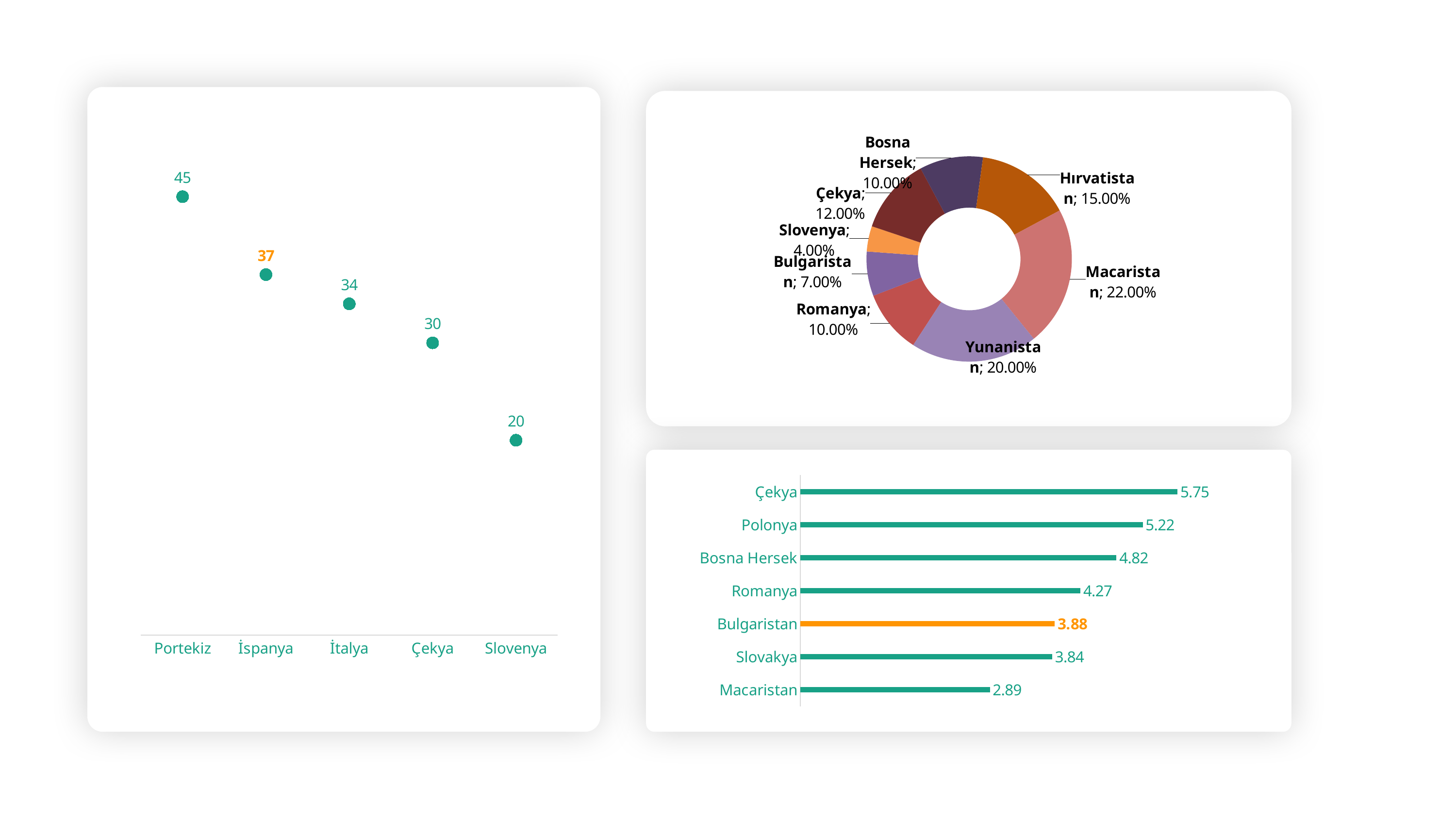
In the left chart, how many data points are plotted? 5 In the left chart, do the values rise or fall from Portekiz to Slovenya? fall In the left chart, what is the value for Portekiz? 45 In the top-right doughnut chart, which category has the smallest share? Slovenya In the left chart, which category has the lowest value? Slovenya In the top-right doughnut chart, how many slices are there? 8 In the top-right doughnut chart, what share does Macaristan have? 22.00% In the bottom-right chart, which bar is highlighted in orange? Bulgaristan In the bottom-right bar chart, what is the value for Romanya? 4.27 In the left chart, what is the difference between the values for Portekiz and Slovenya? 25 In the bottom-right bar chart, what is the difference between Çekya and Macaristan? 2.86 In the bottom-right bar chart, which category has the highest value? Çekya